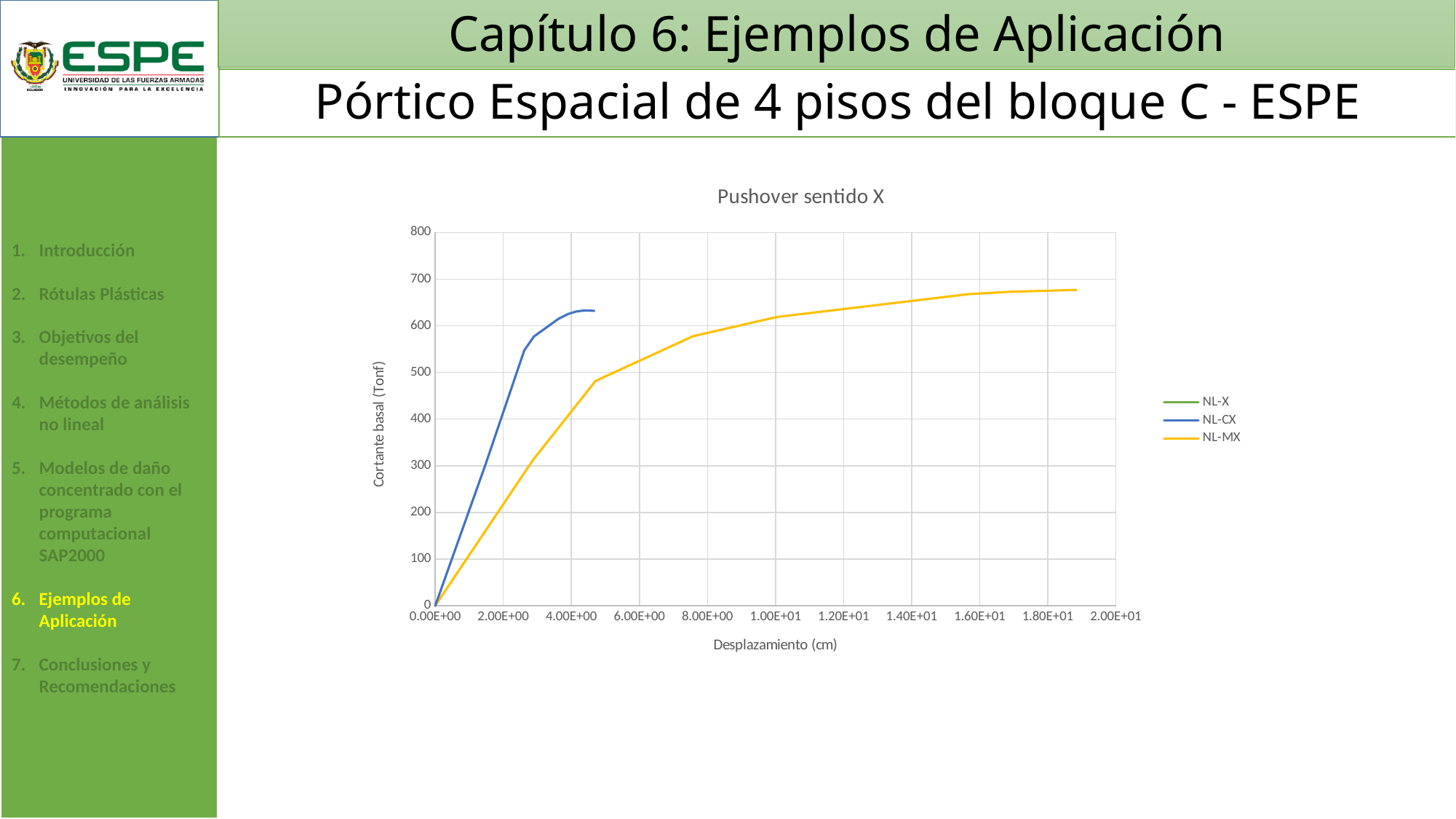
Is the maximum value reached by the NL-CX series greater or less than 700? less What is the title of the chart? Pushover sentido X Is the maximum value reached by the NL-MX series greater or less than 600? greater Which series reaches the higher maximum base shear, NL-CX or NL-MX? NL-MX Is the value of the NL-CX series at a displacement of 3.00E+00 greater or less than 500? greater What kind of chart is shown on the slide? line chart Do the values of the NL-MX series rise or fall as displacement increases? rise What is the label of the vertical axis of the chart? Cortante basal (Tonf) How many series does the chart legend list? 3 Which series extends to the larger displacement, NL-CX or NL-MX? NL-MX